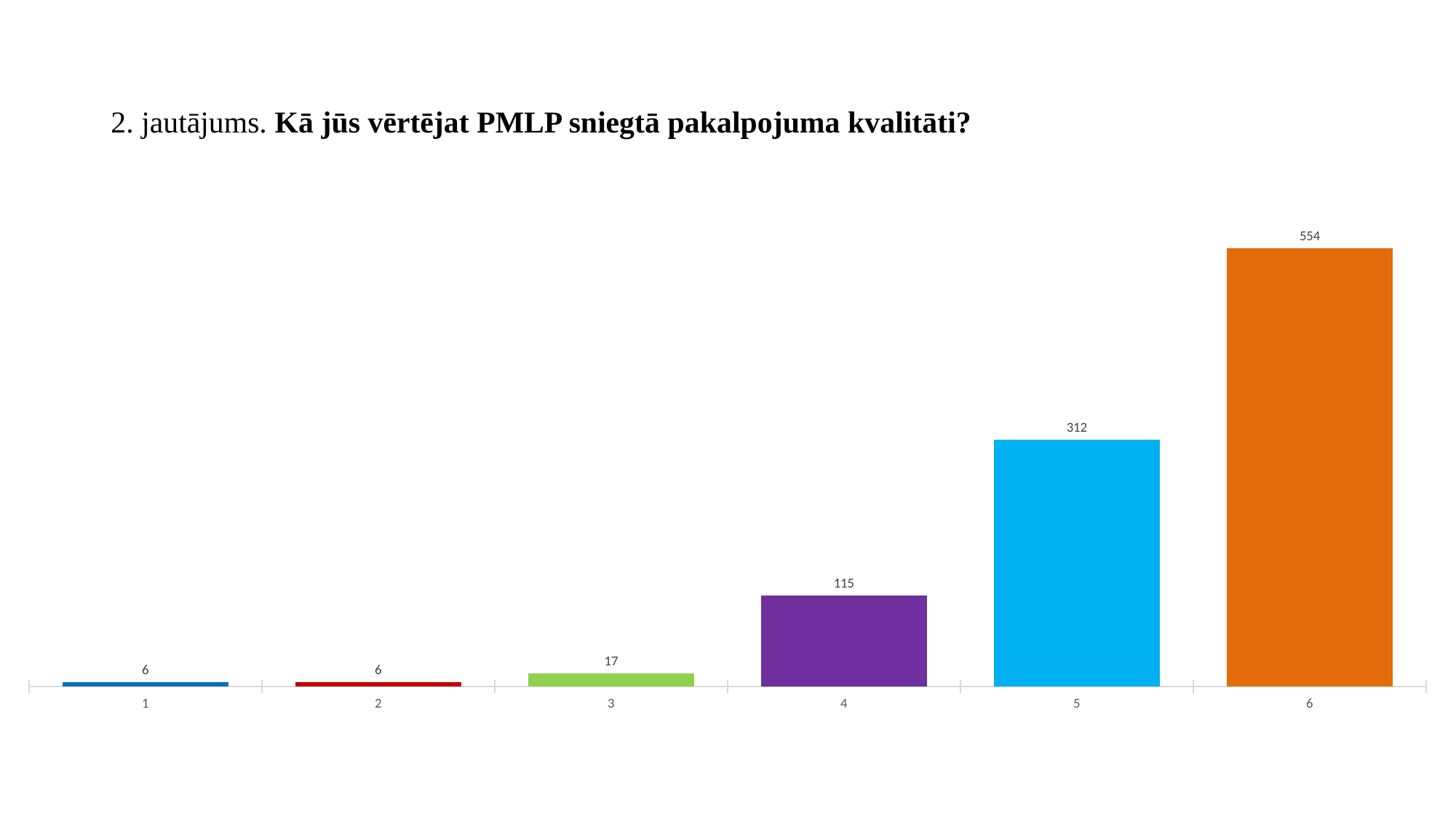
What is the difference between the values for categories 6 and 5? 242 What is the value for category 3? 17 Which category has the highest value? 6 What colour is the bar for category 6? orange What is the value for category 5? 312 What is the value for category 6? 554 Do the values rise or fall from category 1 to category 6? rise What is the value for category 4? 115 What kind of chart is shown on the slide? bar chart Which is larger, the value for category 4 or the value for category 5? 5 How many categories are shown on the x axis? 6 What is the difference between the values for categories 4 and 3? 98